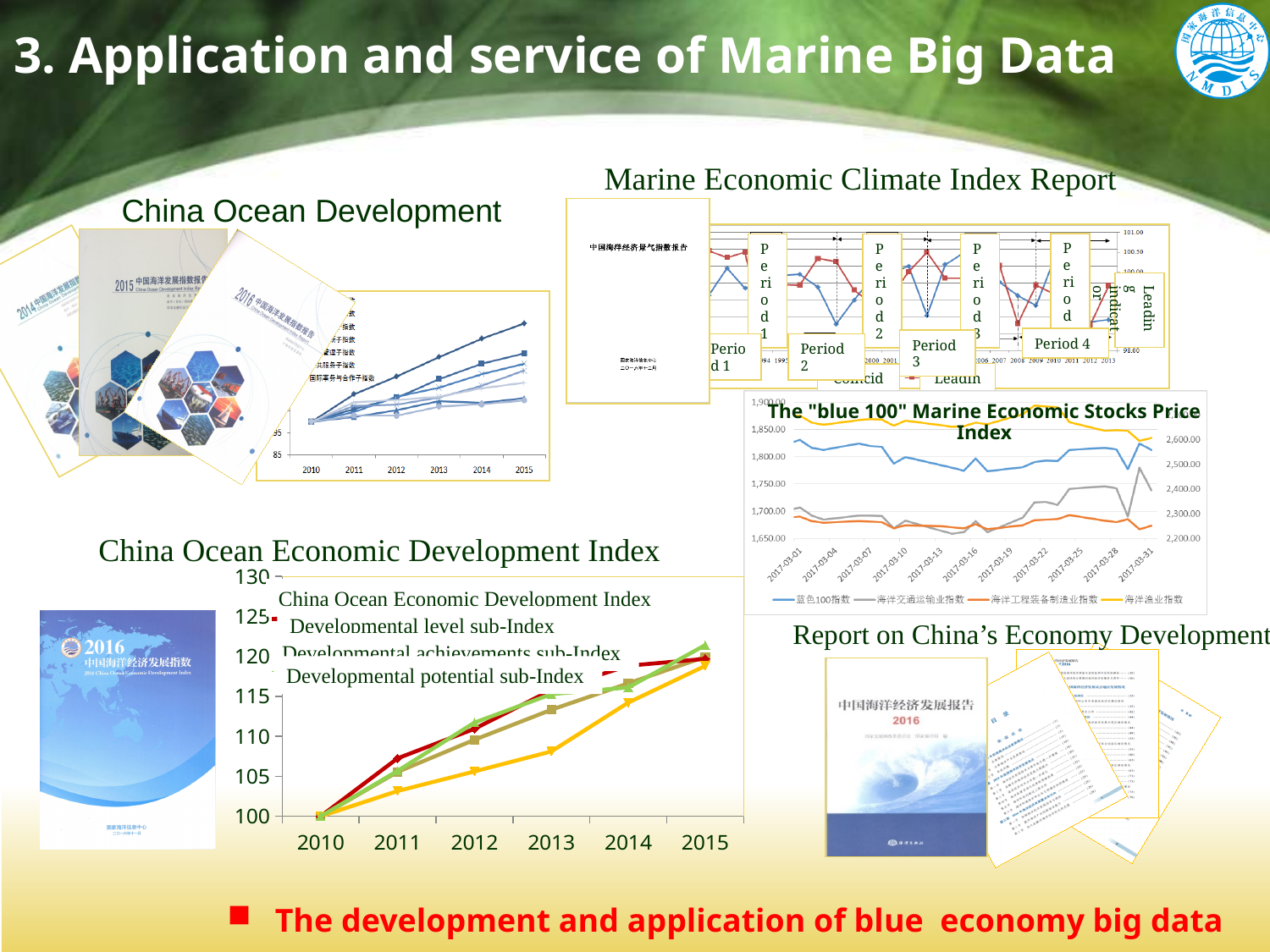
In the China Ocean Economic Development Index chart, is the value for the Developmental level sub-Index in 2011 greater or less than 105? greater How many series does the legend of the "blue 100" Marine Economic Stocks Price Index chart list? 4 What is the title of the line chart on the right side of the slide showing stock price data? The "blue 100" Marine Economic Stocks Price Index How many years are shown on the x axis of the China Ocean Economic Development Index chart? 6 In the China Ocean Economic Development Index chart, do the series rise or fall from 2010 to 2015? rise In the China Ocean Economic Development Index chart, is the value for the Developmental potential sub-Index in 2015 greater or less than 115? greater How many series does the legend of the China Ocean Economic Development Index chart list? 4 What is the first date label on the x axis of the "blue 100" Marine Economic Stocks Price Index chart? 2017-03-01 In the China Ocean Economic Development Index chart, is the value for the Developmental potential sub-Index in 2013 greater or less than 110? greater In the China Ocean Economic Development Index chart, what is the value of the series in 2010? 100 What kind of chart is the China Ocean Economic Development Index chart at the bottom left? line chart